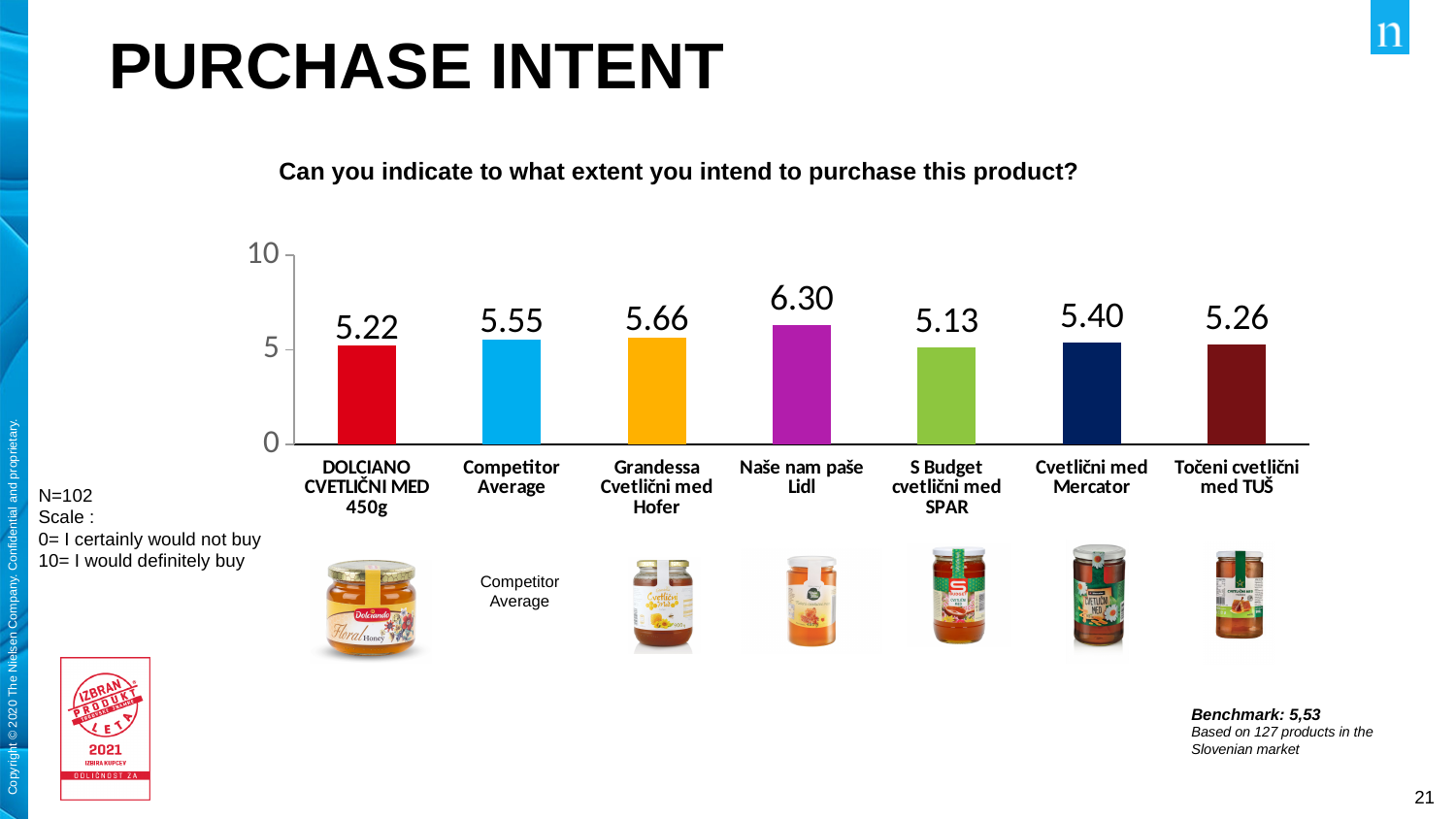
What is the purchase intent value for DOLCIANO CVETLIČNI MED 450g? 5.22 What type of chart is shown on the slide? Bar chart What is the value shown for Cvetlični med Mercator? 5.40 What is the maximum value shown on the vertical axis of the chart? 10 What is the value shown for Competitor Average? 5.55 Which product has the highest purchase intent score? Naše nam paše Lidl Which product has the lowest purchase intent score? S Budget cvetlični med SPAR What is the difference between the values for Naše nam paše Lidl and S Budget cvetlični med SPAR? 1.17 Which has a higher value, Grandessa Cvetlični med Hofer or Točeni cvetlični med TUŠ? Grandessa Cvetlični med Hofer What is the difference between the Competitor Average and DOLCIANO CVETLIČNI MED 450g? 0.33 What is the purchase intent value for Naše nam paše Lidl? 6.30 How many bars are shown in the chart? 7